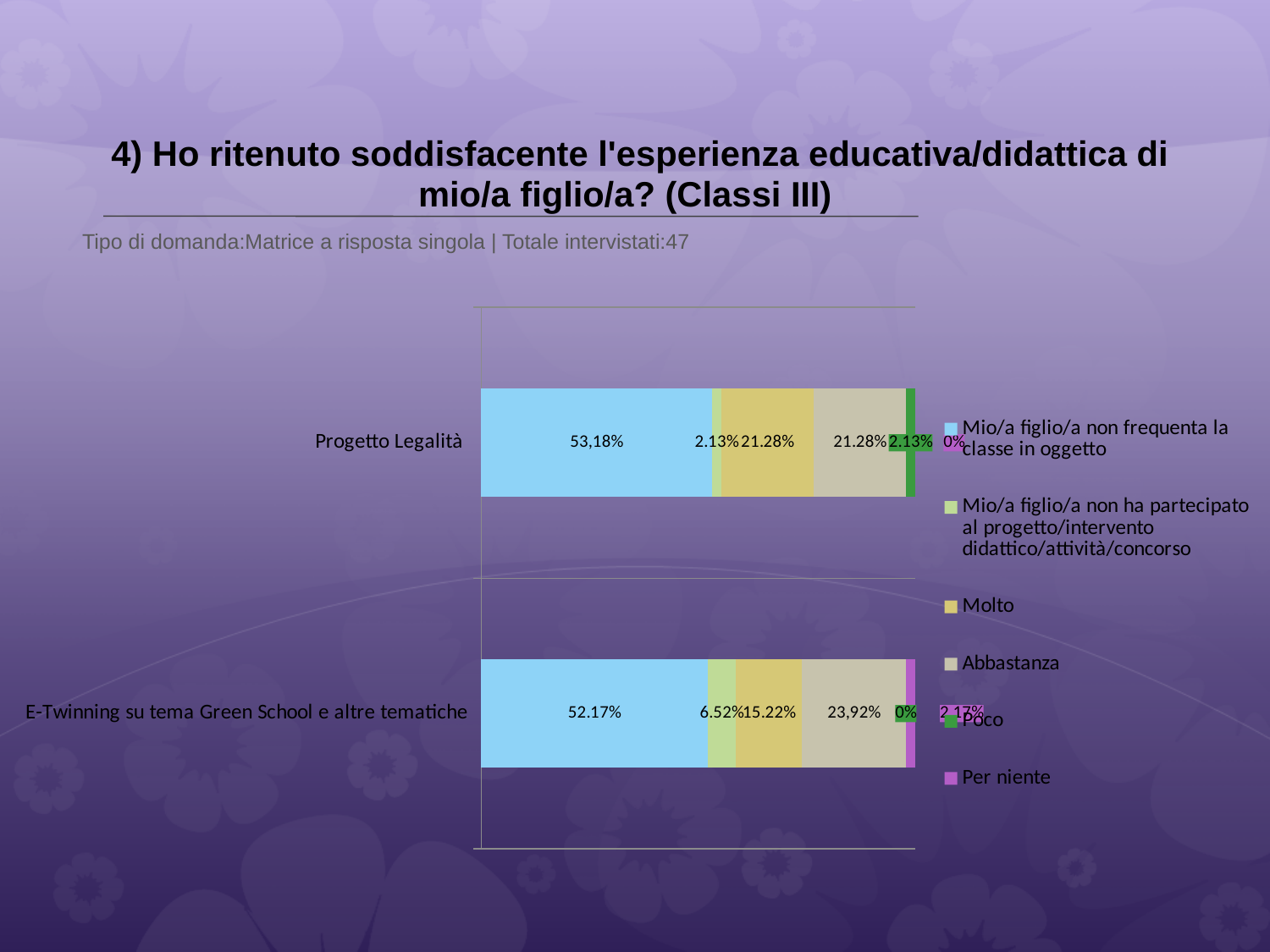
What is the value of 'Poco' for E-Twinning su tema Green School e altre tematiche? 0% How many series does the legend list? 6 What is the value of 'Abbastanza' for E-Twinning su tema Green School e altre tematiche? 23,92% What is the difference between the 'Molto' values for Progetto Legalità and E-Twinning su tema Green School e altre tematiche? 6.06% Which category has the larger 'Mio/a figlio/a non ha partecipato al progetto/intervento didattico/attività/concorso' value, Progetto Legalità or E-Twinning su tema Green School e altre tematiche? E-Twinning su tema Green School e altre tematiche What is the value of 'Molto' for E-Twinning su tema Green School e altre tematiche? 15.22% What type of chart is shown on the slide? stacked bar chart How many categories (rows) does the chart show? 2 What is the value of 'Per niente' for Progetto Legalità? 0% Which legend entry is shown in magenta? Per niente What is the value of 'Mio/a figlio/a non frequenta la classe in oggetto' for Progetto Legalità? 53,18% What is the value of 'Molto' for Progetto Legalità? 21.28%